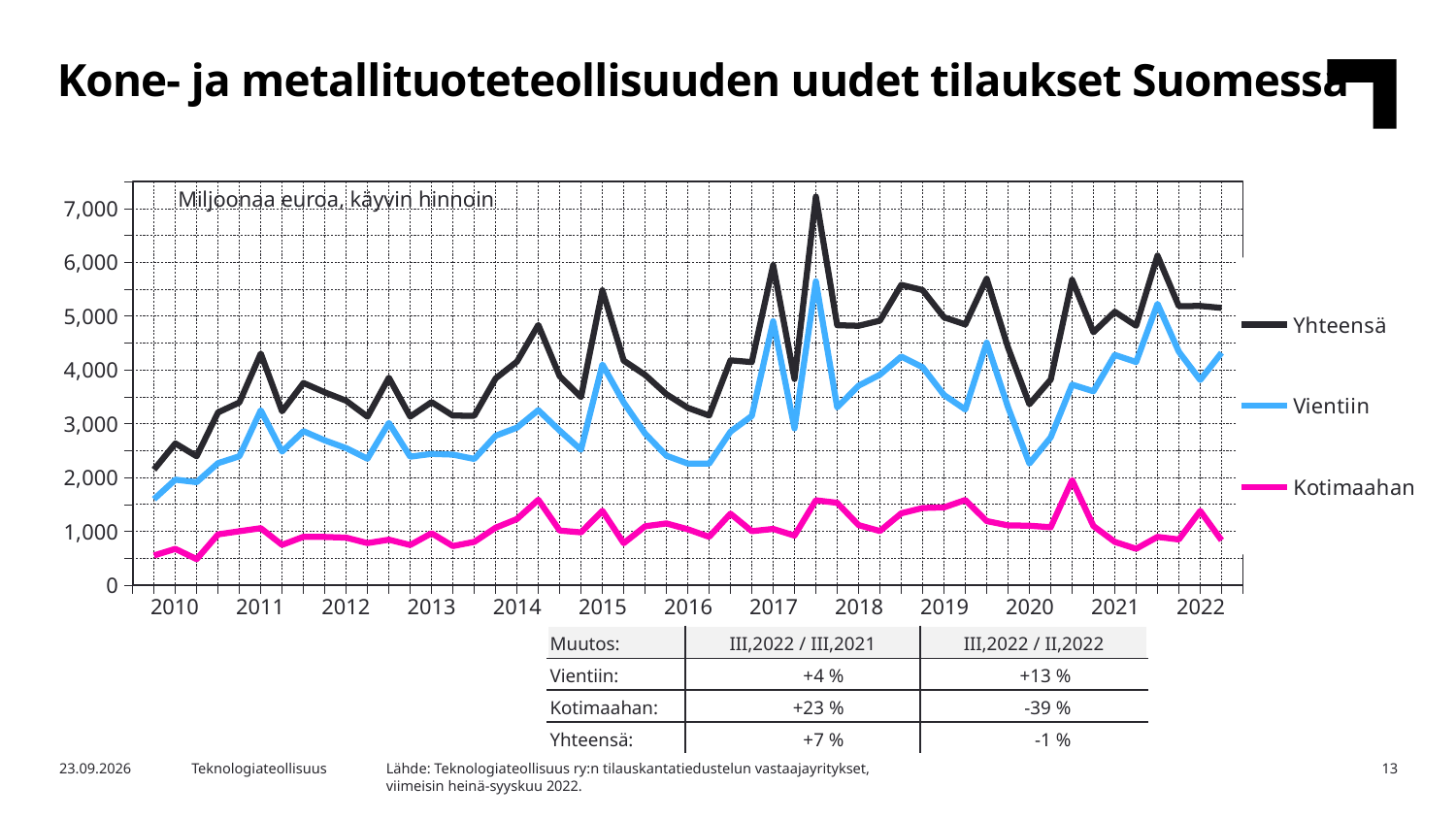
Is the peak value of the Yhteensä series in 2017 greater or less than 7,000? greater What are the three series named in the legend? Yhteensä, Vientiin, Kotimaahan Does the Yhteensä series generally rise or fall from 2010 to 2022? rise Which series is larger in 2022, Vientiin or Kotimaahan? Vientiin Which series has the highest values throughout the chart? Yhteensä Is the value of the Kotimaahan series at the start of 2010 greater or less than 1,000? less What unit is stated in the chart's label at the top of the plot area? Miljoonaa euroa, käyvin hinnoin Is the value of the Vientiin series at the start of 2010 greater or less than 2,000? less What kind of chart is shown on the slide? line chart Which series has the lowest values throughout the chart? Kotimaahan What is the first year shown on the x axis? 2010 How many series does the legend list? 3